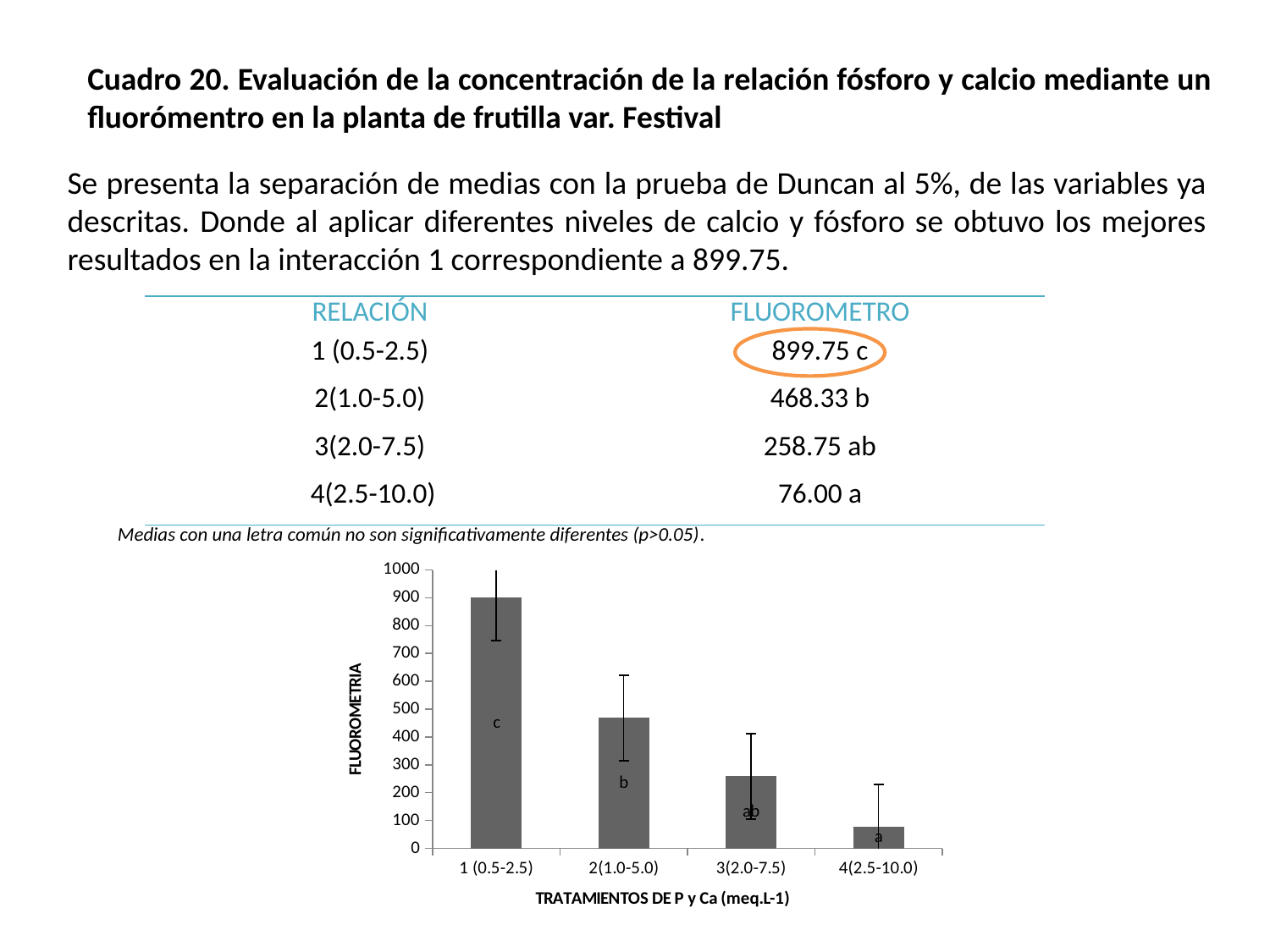
What is the title of the x axis of the bar chart? TRATAMIENTOS DE P y Ca (meq.L-1) Which treatment has the highest bar in the chart? 1 (0.5-2.5) Is the bar for treatment 2(1.0-5.0) greater or less than 500? less What is the title of the y axis of the bar chart? FLUOROMETRIA How many treatment categories are plotted on the x axis of the bar chart? 4 What kind of chart is shown at the bottom of the slide? bar chart Is the bar for treatment 3(2.0-7.5) greater or less than 200? greater Is the bar for treatment 1 (0.5-2.5) greater or less than 800? greater Do the bar values rise or fall from left to right along the x axis? fall Which bar is taller: 2(1.0-5.0) or 3(2.0-7.5)? 2(1.0-5.0) Which treatment has the lowest bar in the chart? 4(2.5-10.0)